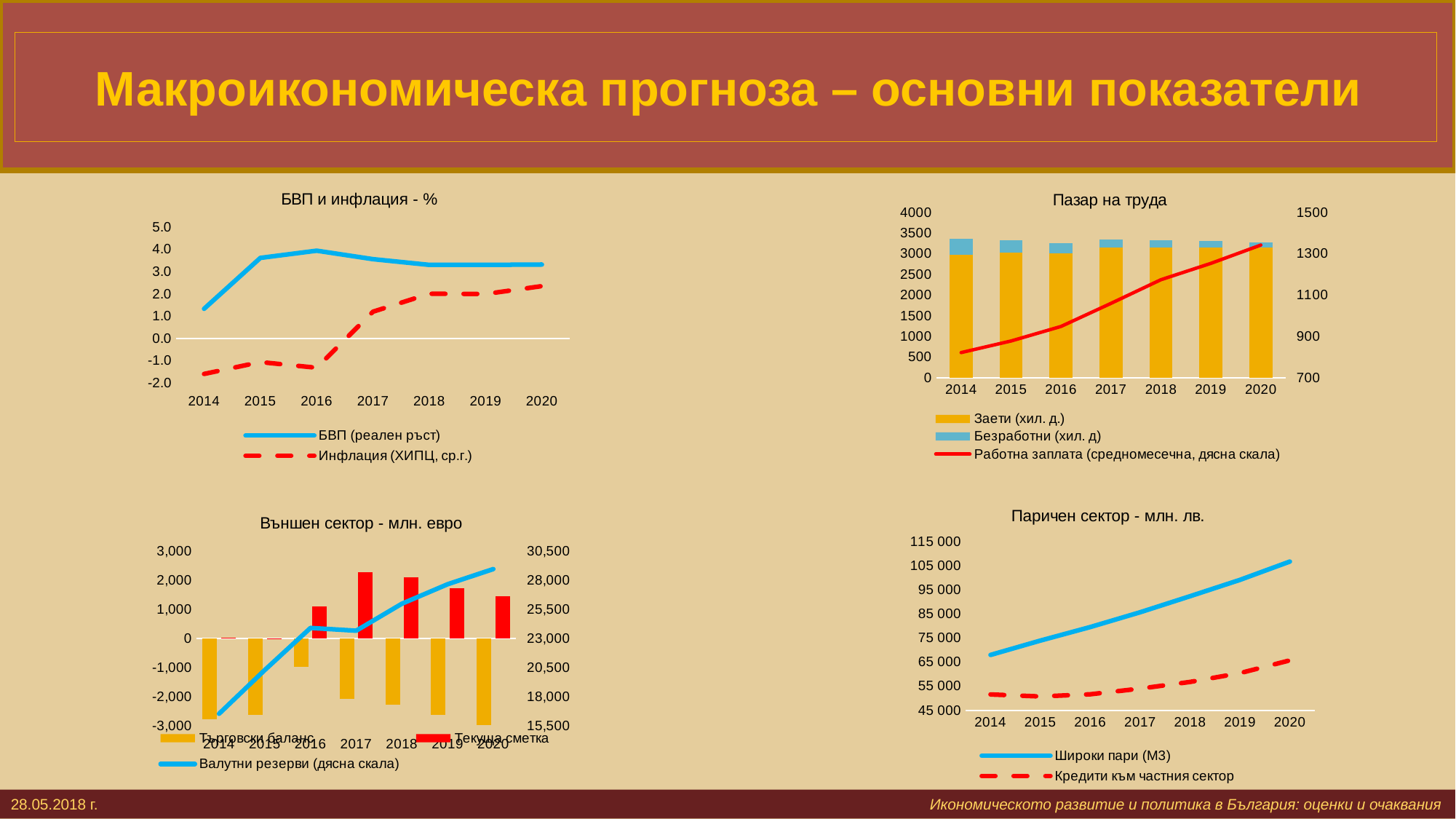
In the 'Паричен сектор - млн. лв.' chart, which series has the larger value in 2017, Широки пари (М3) or Кредити към частния сектор? Широки пари (М3) In the 'Паричен сектор - млн. лв.' chart, is the value for Широки пари (М3) in 2020 greater or less than 95 000? greater In the 'БВП и инфлация - %' chart, which year has the highest value for БВП (реален ръст)? 2016 In the 'Паричен сектор - млн. лв.' chart, which series is drawn as a dashed red line? Кредити към частния сектор In the 'БВП и инфлация - %' chart, is the value for Инфлация (ХИПЦ, ср.г.) in 2014 greater or less than 0.0? less How many series does the legend of the 'Пазар на труда' chart list? 3 In the 'Пазар на труда' chart, is the value for Работна заплата in 2014 greater or less than 900 on the right-hand scale? less In the 'Пазар на труда' chart, does the Работна заплата line rise or fall from 2014 to 2020? rises What kind of chart is the 'БВП и инфлация - %' chart? line chart How many years are shown on the x axis of the 'Външен сектор - млн. евро' chart? 7